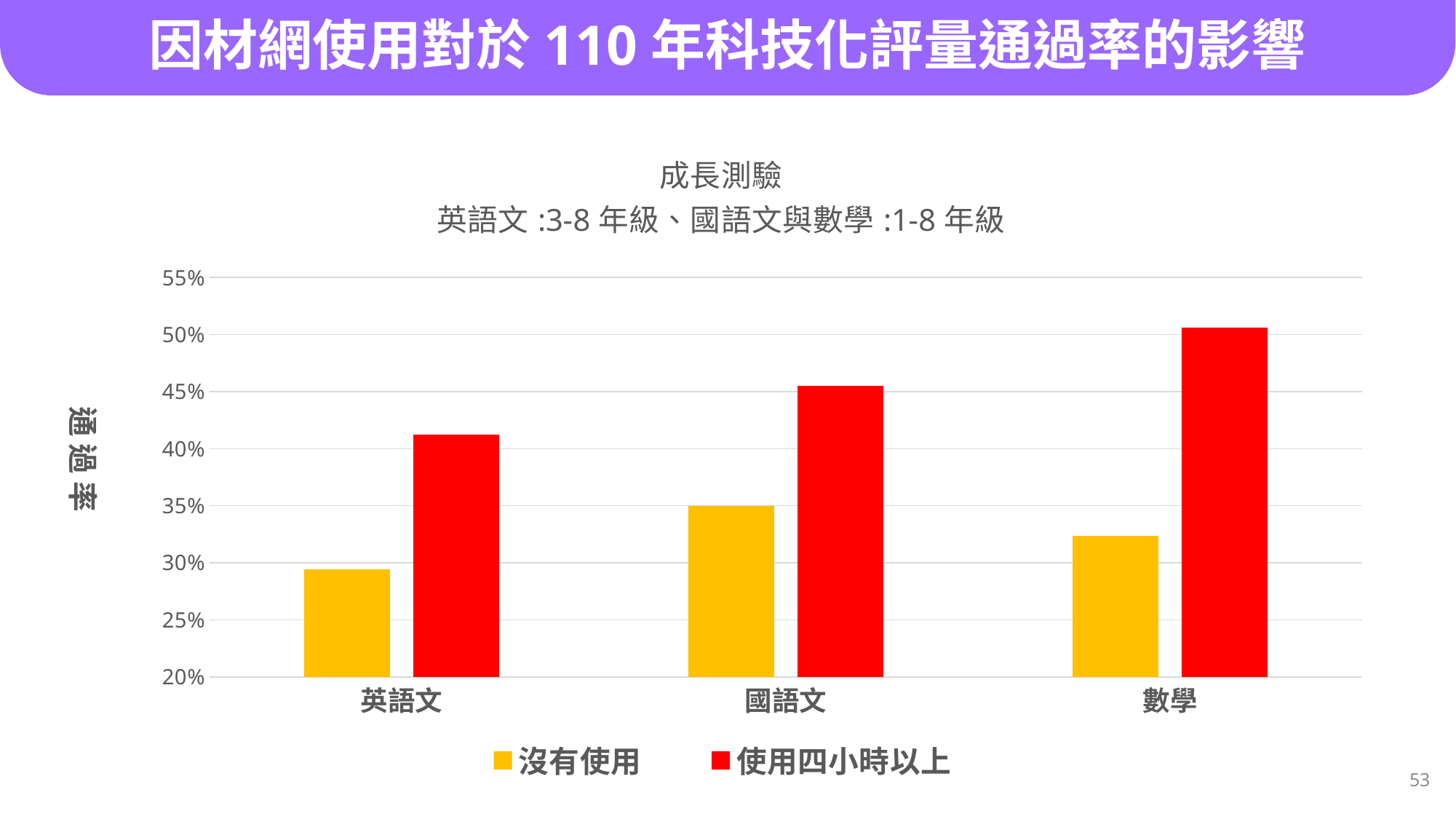
Is the 使用四小時以上 value for 數學 greater or less than 45%? greater What kind of chart is shown on the slide? bar chart Which is larger: the 沒有使用 value for 國語文 or the 沒有使用 value for 數學? 國語文 Is the 使用四小時以上 value for 英語文 greater or less than 40%? greater Is the 沒有使用 value for 數學 greater or less than 35%? less How many series does the legend list? 2 How many subject categories are shown on the x axis? 3 Do the 使用四小時以上 values rise or fall from 英語文 to 數學 along the x axis? rise Which subject has the lowest value for 沒有使用? 英語文 Which subject has the highest value for 使用四小時以上? 數學 What colour are the bars for the 使用四小時以上 series? red